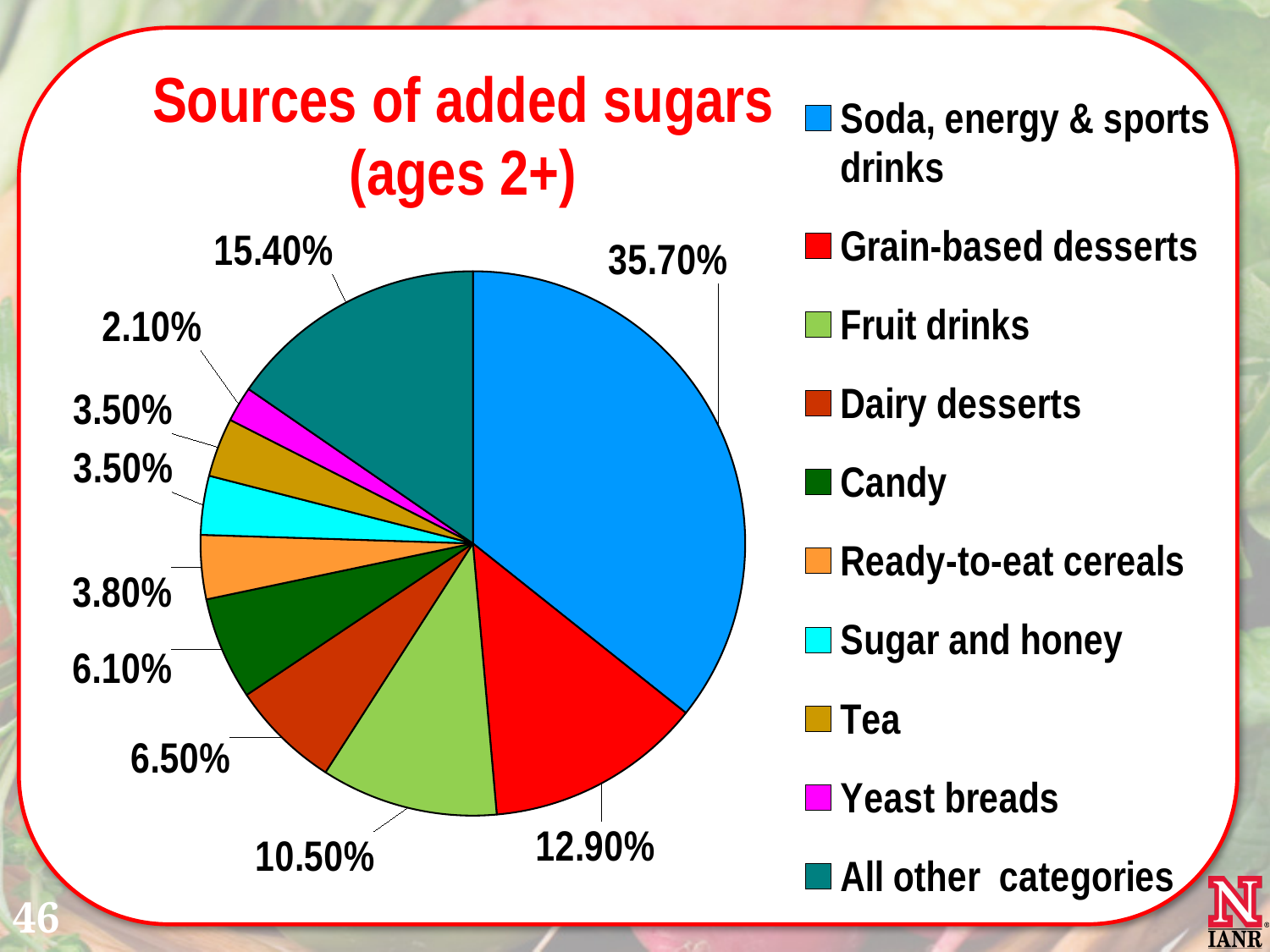
What share of added sugars comes from fruit drinks? 10.50% Which category has the smallest slice of the pie? Yeast breads What kind of chart is shown on the slide? Pie chart How many categories does the legend list? 10 Which is larger, the share for dairy desserts or the share for candy? Dairy desserts What is the difference between the share for soda, energy & sports drinks and the share for all other categories? 20.30% What is the title of the chart? Sources of added sugars (ages 2+) What share of added sugars comes from soda, energy & sports drinks? 35.70% What share of added sugars comes from grain-based desserts? 12.90% What share of added sugars comes from yeast breads? 2.10% Which category has the largest slice of the pie? Soda, energy & sports drinks What colour is the slice for ready-to-eat cereals? Orange